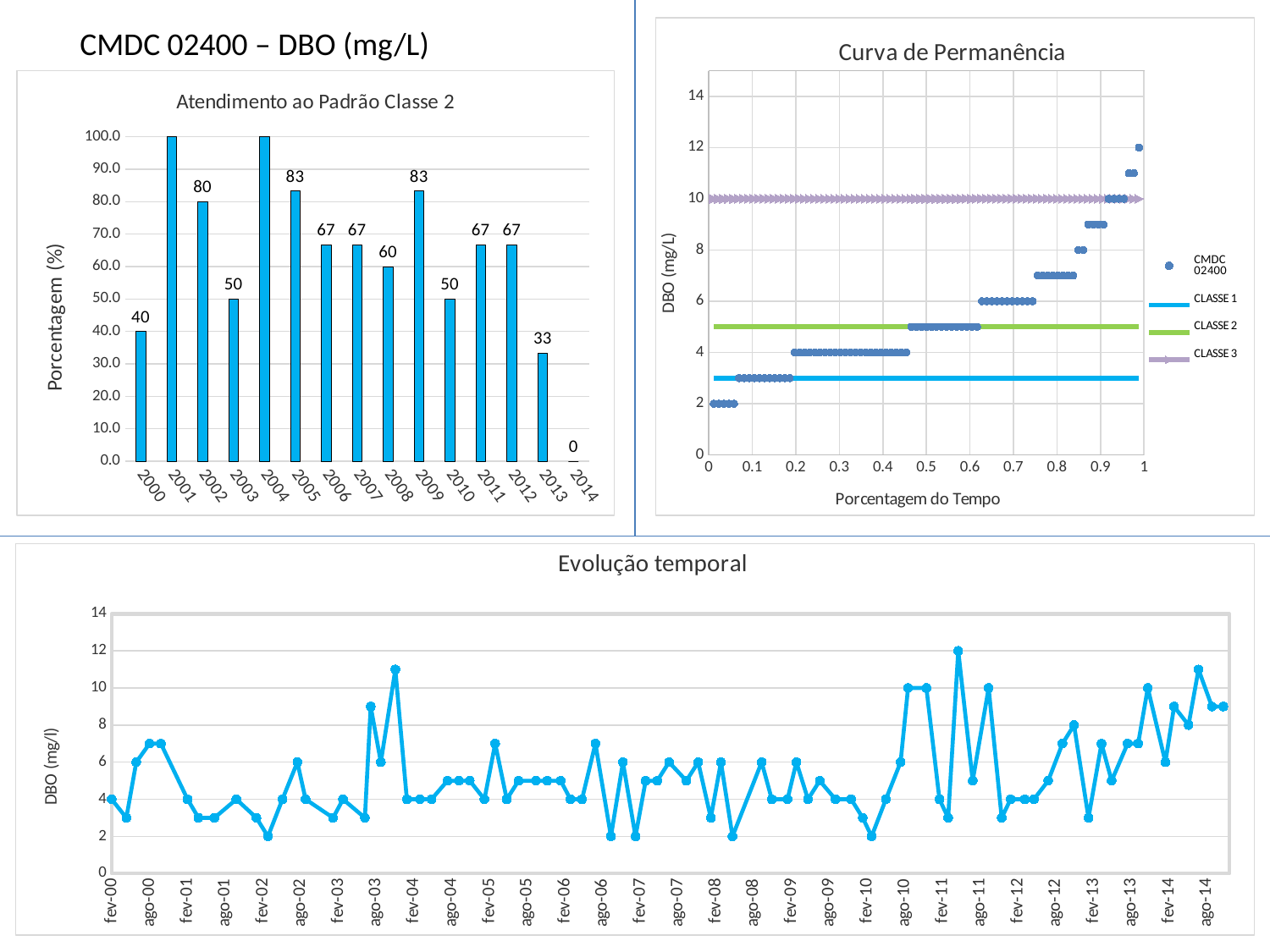
In the 'Atendimento ao Padrão Classe 2' chart, is the value for 2001 greater or less than 90.0? greater In the 'Atendimento ao Padrão Classe 2' chart, which year has the lowest value? 2014 In the 'Atendimento ao Padrão Classe 2' chart, which is larger, the value for 2005 or the value for 2010? 2005 In the 'Atendimento ao Padrão Classe 2' chart, what is the value for 2000? 40 In the 'Atendimento ao Padrão Classe 2' chart, what is the value for 2008? 60 In the 'Atendimento ao Padrão Classe 2' chart, what is the value for 2013? 33 What kind of chart is 'Atendimento ao Padrão Classe 2'? bar chart In the 'Atendimento ao Padrão Classe 2' chart, what is the difference between the values for 2002 and 2003? 30 In the 'Evolução temporal' chart, is the highest plotted value greater or less than 10? greater What is the x-axis title of the 'Curva de Permanência' chart? Porcentagem do Tempo How many years are shown on the x axis of the 'Atendimento ao Padrão Classe 2' chart? 15 How many series does the legend of the 'Curva de Permanência' chart list? 4